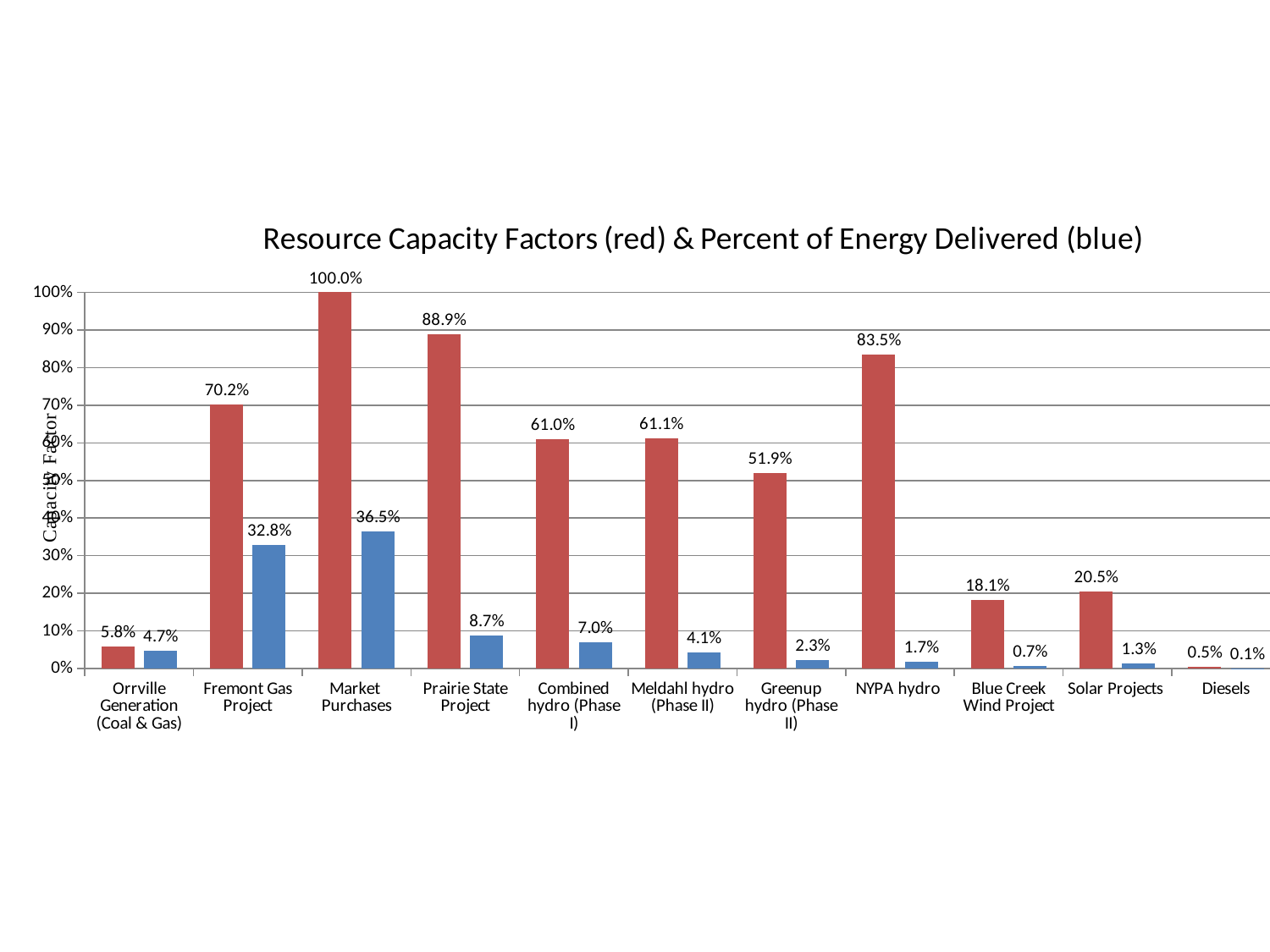
What is the capacity factor (red bar) for NYPA hydro? 83.5% What is the percent of energy delivered (blue bar) for Market Purchases? 36.5% What is the difference between the capacity factor and the percent of energy delivered for the Prairie State Project? 80.2% What is the percent of energy delivered (blue bar) for the Fremont Gas Project? 32.8% Which has a higher capacity factor (red bar): Greenup hydro (Phase II) or Combined hydro (Phase I)? Combined hydro (Phase I) What is the capacity factor (red bar) for the Prairie State Project? 88.9% What kind of chart is shown on the slide? Bar chart Which resource has the highest capacity factor (red bar)? Market Purchases How many resource categories are shown on the x axis? 11 Is the capacity factor (red bar) for the Fremont Gas Project greater or less than 60%? greater What is the title of the chart? Resource Capacity Factors (red) & Percent of Energy Delivered (blue) Which resource has the lowest percent of energy delivered (blue bar)? Diesels